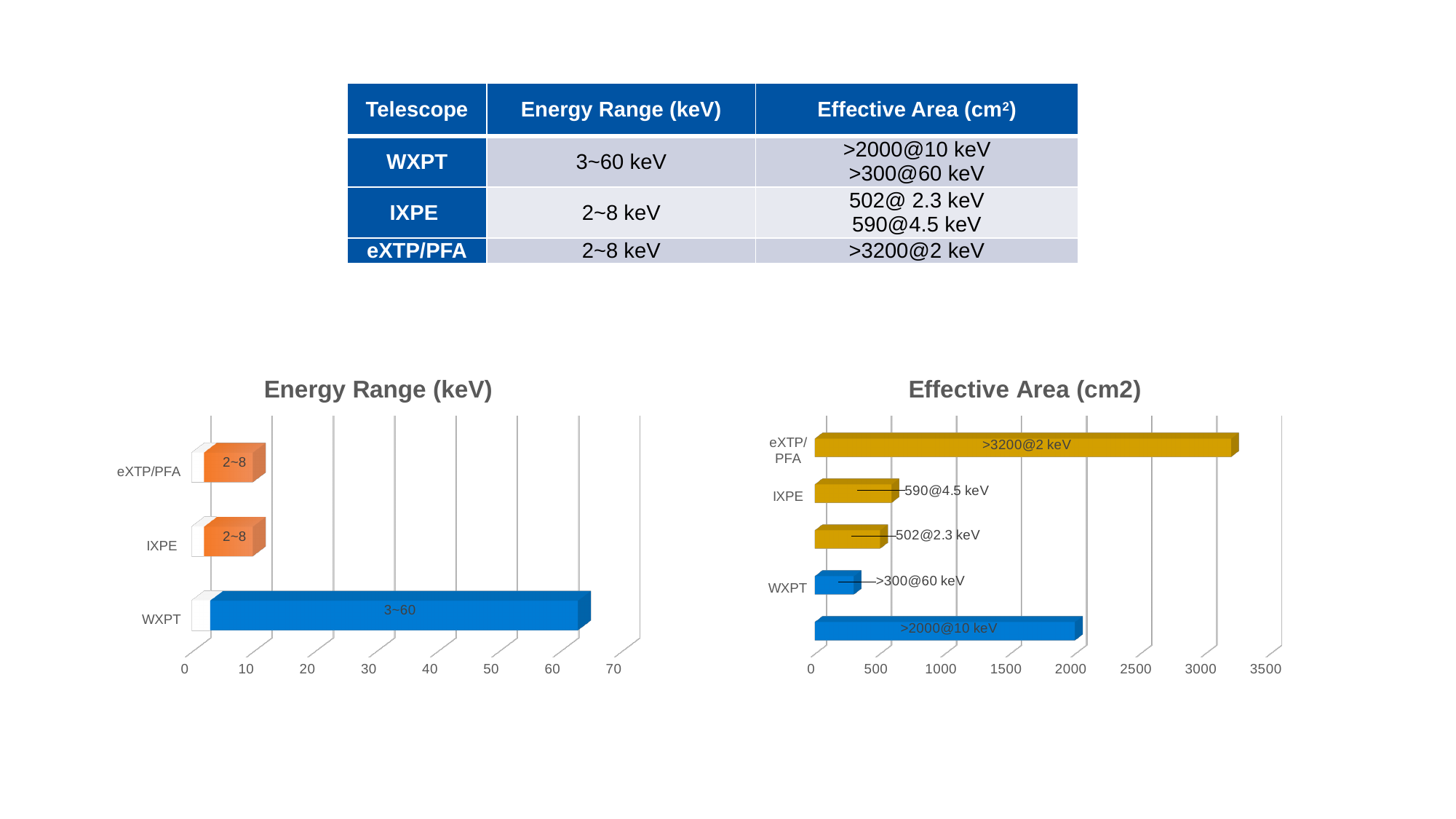
In the Effective Area (cm2) chart, what is the difference between the two IXPE values, 590 and 502? 88 How many telescopes are listed on the category axis of the Energy Range (keV) chart? 3 In the Effective Area (cm2) chart, which telescope has the longest bar? eXTP/PFA In the Energy Range (keV) chart, which telescope has the longest bar? WXPT In the Energy Range (keV) chart, what is the data label on the WXPT bar? 3~60 In the Effective Area (cm2) chart, which data label belongs to the shortest bar? >300@60 keV In the Effective Area (cm2) chart, what is the data label on the eXTP/PFA bar? >3200@2 keV In the Effective Area (cm2) chart, is the WXPT bar labelled >300@60 keV greater or less than 500? less In the Energy Range (keV) chart, what is the data label on the eXTP/PFA bar? 2~8 What kind of chart is the Energy Range (keV) chart? bar chart How many bars are plotted in the Effective Area (cm2) chart? 5 In the Effective Area (cm2) chart, is the eXTP/PFA bar greater or less than 3000? greater